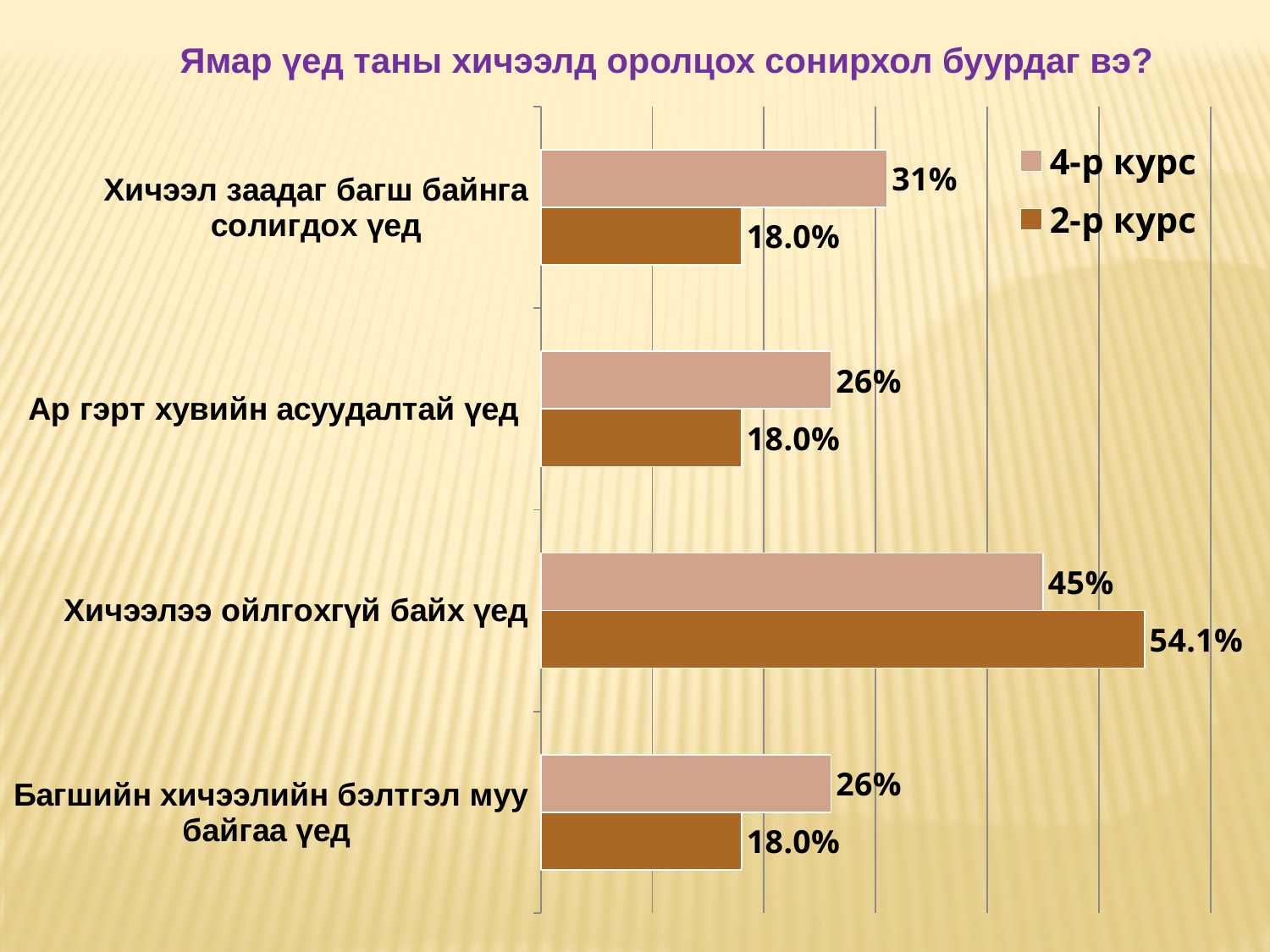
In the category 'Хичээл заадаг багш байнга солигдох үед', which series has the larger value, 4-р курс or 2-р курс? 4-р курс How many categories are shown in the chart? 4 Which category has the highest value for the 2-р курс series? Хичээлээ ойлгохгүй байх үед What is the value for 4-р курс in the category 'Ар гэрт хувийн асуудалтай үед'? 26% What is the value for 4-р курс in the category 'Хичээл заадаг багш байнга солигдох үед'? 31% How many series does the legend list? 2 In the category 'Хичээлээ ойлгохгүй байх үед', which series has the larger value, 4-р курс or 2-р курс? 2-р курс What is the difference between the 4-р курс and 2-р курс values in the category 'Хичээл заадаг багш байнга солигдох үед'? 13% What is the value for 2-р курс in the category 'Хичээлээ ойлгохгүй байх үед'? 54.1% Which category has the highest value for the 4-р курс series? Хичээлээ ойлгохгүй байх үед What type of chart is shown on the slide? Bar chart What is the value for 2-р курс in the category 'Багшийн хичээлийн бэлтгэл муу байгаа үед'? 18.0%